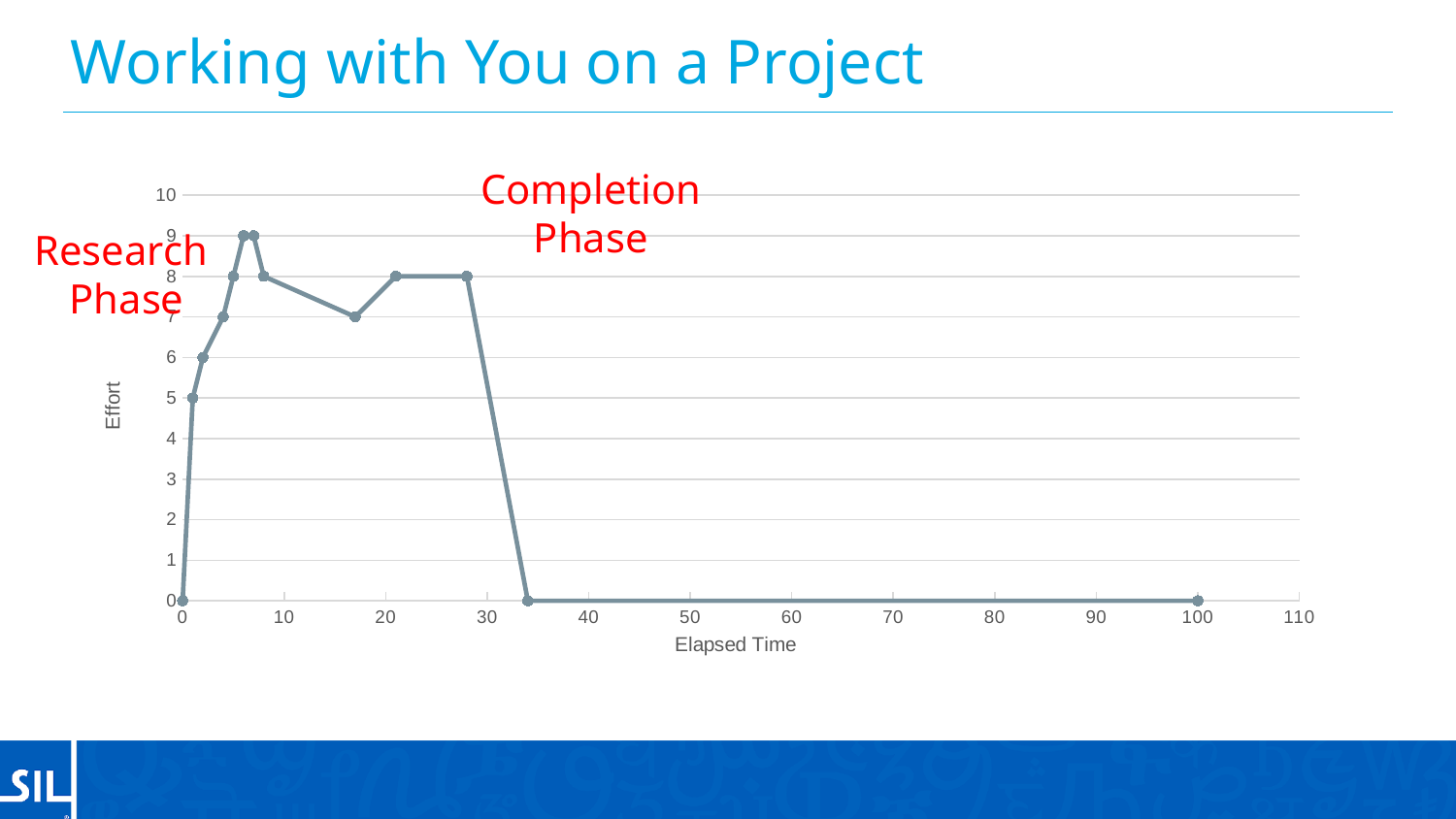
What kind of chart is shown on the slide? line chart What is the Effort value at Elapsed Time 0? 0 What is the lowest Effort value plotted on the chart? 0 What is the title of the x axis of the chart? Elapsed Time What is the title of the y axis of the chart? Effort Is the Effort value at Elapsed Time 20 greater or less than 5? greater What is the Effort value at Elapsed Time 100? 0 Which is larger, the Effort at Elapsed Time 10 or the Effort at Elapsed Time 60? Elapsed Time 10 What is the highest Effort value reached on the chart? 9 Does the Effort rise or fall between Elapsed Time 0 and Elapsed Time 6? rise Is the Effort value at Elapsed Time 50 greater or less than 5? less Does the Effort rise, fall, or stay flat between Elapsed Time 40 and Elapsed Time 100? stay flat